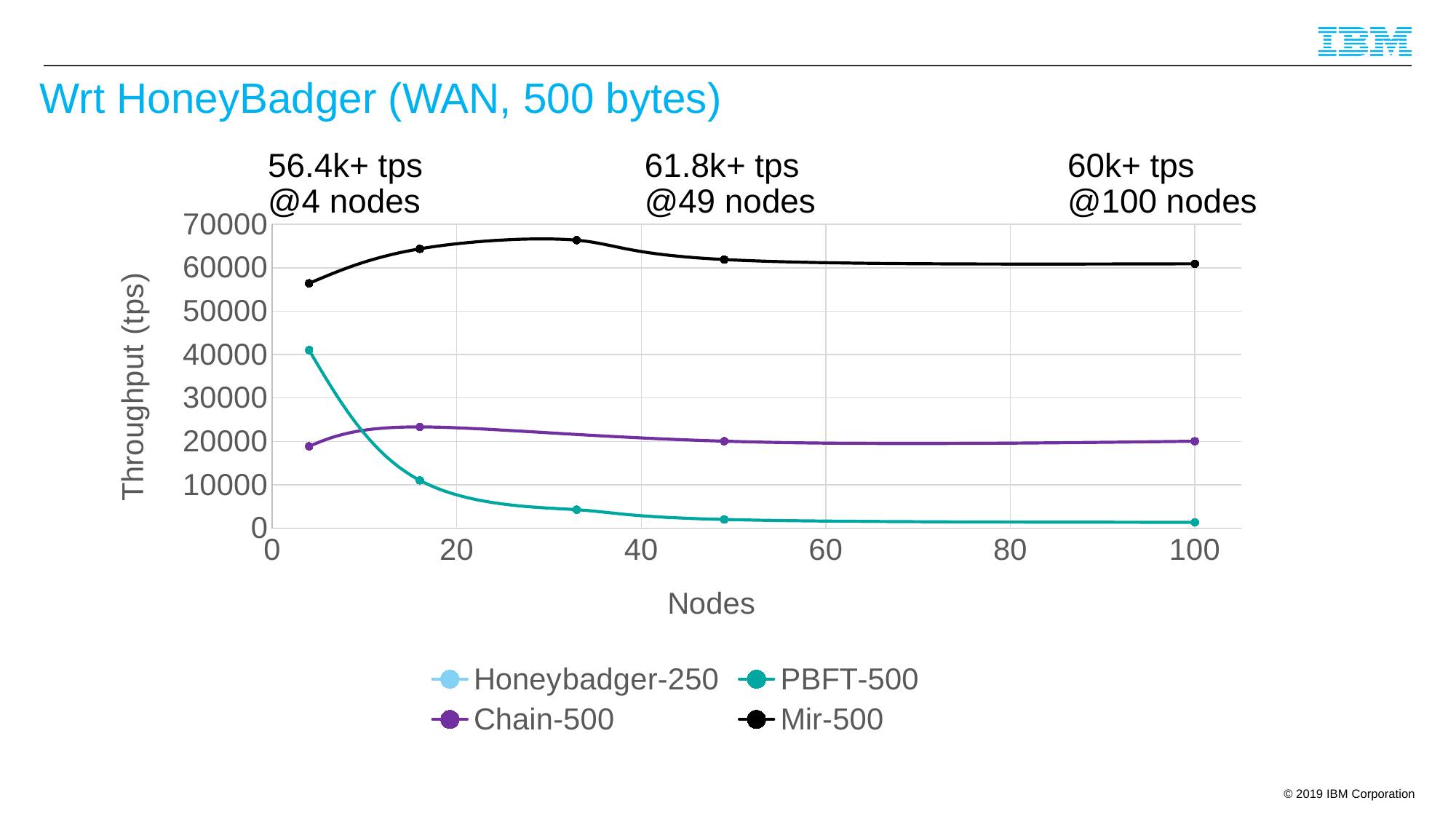
Is the throughput of PBFT-500 at 100 nodes greater or less than 10000? less Is the throughput of Mir-500 at 4 nodes greater or less than 50000? greater Which of the plotted series has the lowest throughput at 4 nodes? Chain-500 How many series does the legend list? 4 Is the throughput of Chain-500 at 16 nodes greater or less than 20000? greater What is the title of the chart? Wrt HoneyBadger (WAN, 500 bytes) Does the throughput of PBFT-500 rise or fall as the number of nodes increases? Fall Which of the plotted series has the highest throughput at 100 nodes? Mir-500 What is the label of the y axis? Throughput (tps) At 49 nodes, which has higher throughput, Mir-500 or Chain-500? Mir-500 What kind of chart is shown on the slide? Line chart